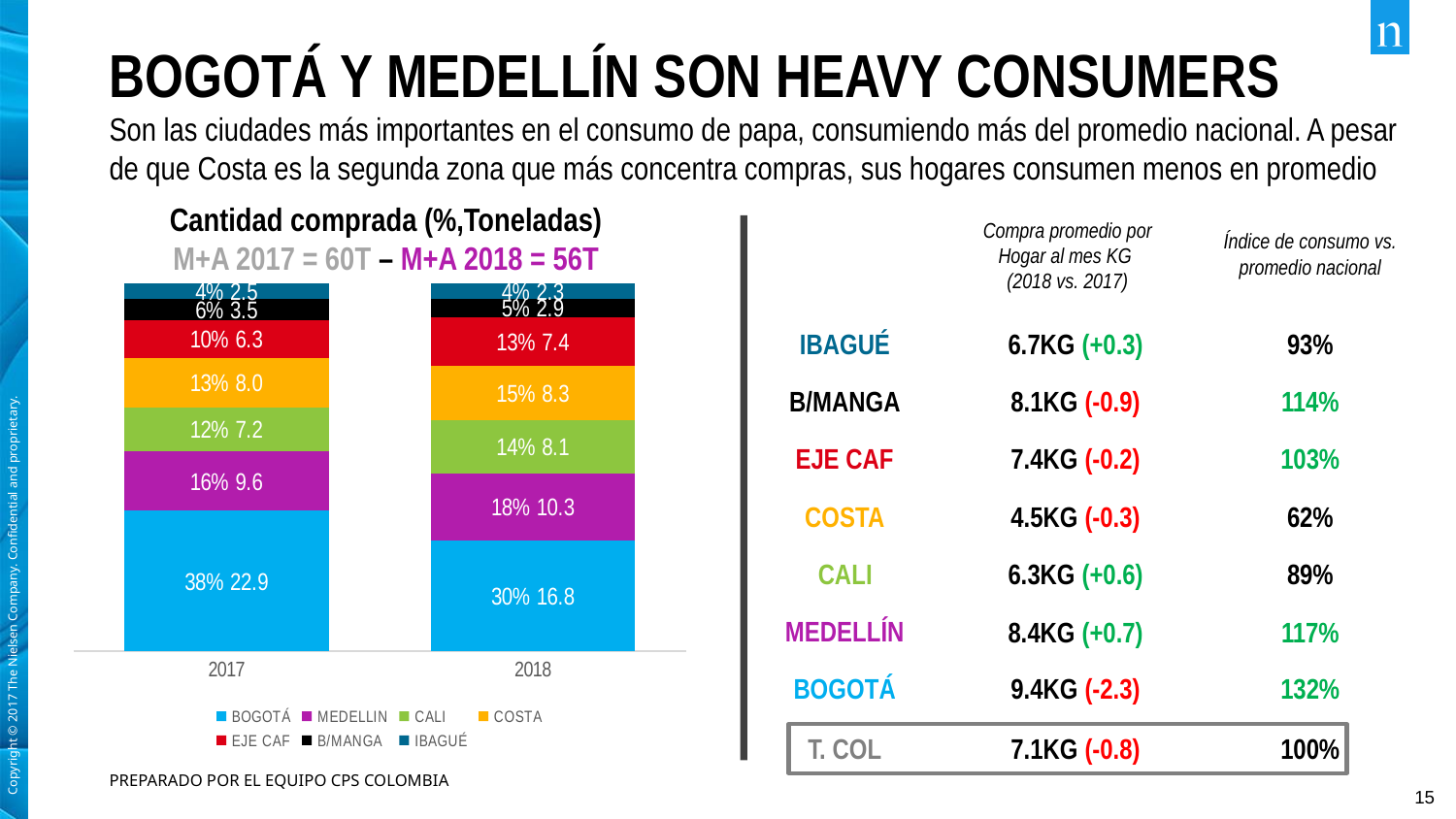
In the "Cantidad comprada" chart, does BOGOTÁ's percentage share rise or fall from 2017 to 2018? Fall In the "Cantidad comprada" chart, what percentage share does MEDELLIN have in 2018? 18% How many bars (years) are plotted in the "Cantidad comprada" chart? 2 In the "Cantidad comprada" chart, which city has the largest segment in the 2017 bar? BOGOTÁ In the "Cantidad comprada" chart, which city has the smallest segment in the 2018 bar? IBAGUÉ According to the subtitle of the "Cantidad comprada" chart, what is the total for M+A 2018? 56T In the "Cantidad comprada" chart, what is the tonnage value for BOGOTÁ in 2017? 22.9 What kind of chart is shown under the title "Cantidad comprada (%,Toneladas)"? Stacked bar chart In the "Cantidad comprada" chart, what is the tonnage value for COSTA in 2018? 8.3 In the "Cantidad comprada" chart, which is larger in 2018: the tonnage for CALI or for EJE CAF? CALI In the "Cantidad comprada" chart, by how many tonnes did BOGOTÁ's value change from 2017 (22.9) to 2018 (16.8)? 6.1 How many series does the legend of the "Cantidad comprada" chart list? 7